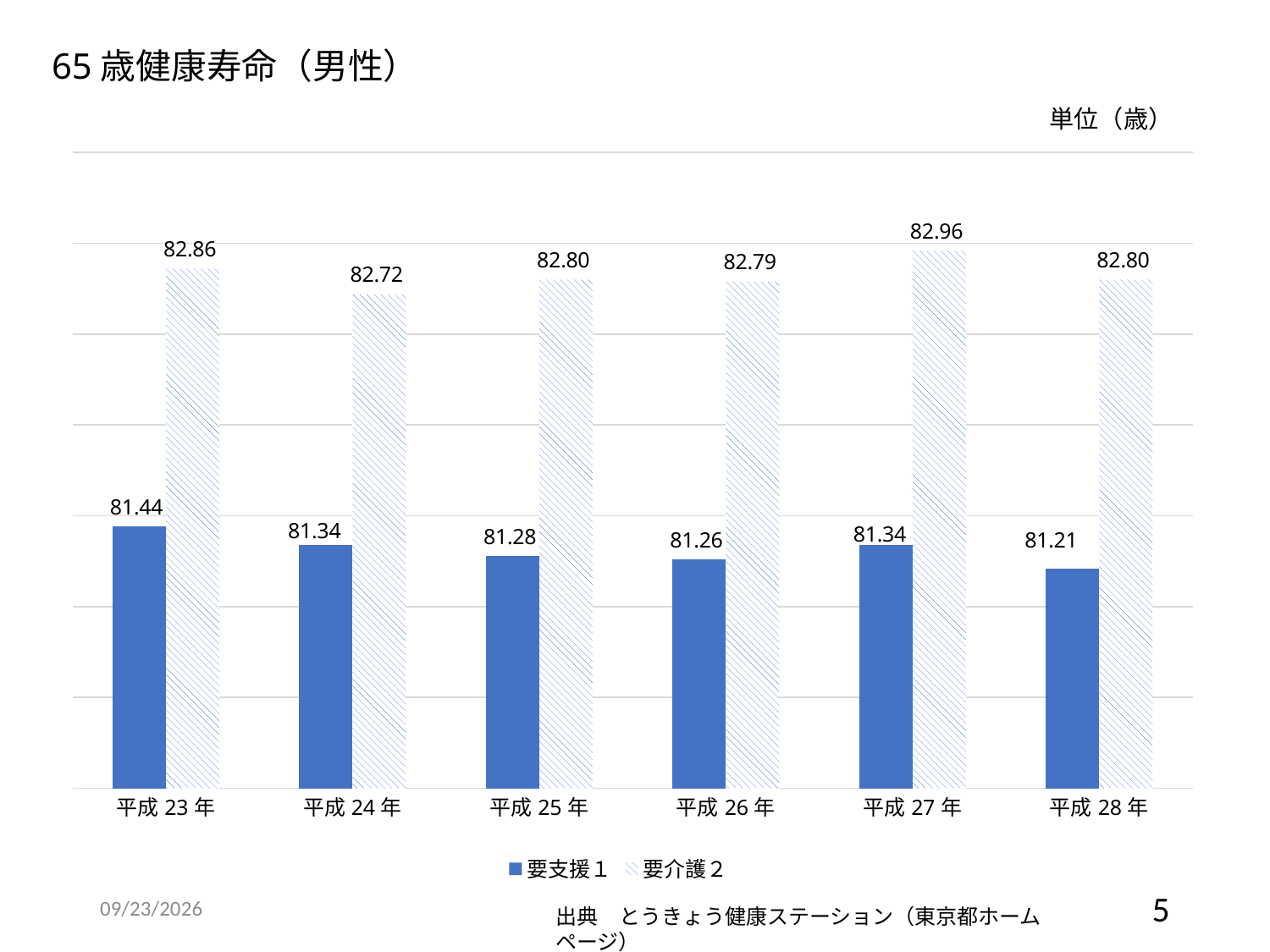
What is the value for 要支援１ in 平成 23 年? 81.44 What kind of chart is shown on the slide? Bar chart How many series does the legend list? 2 How many years are shown on the x axis? 6 What is the value for 要介護２ in 平成 24 年? 82.72 What is the title of the slide? 65 歳健康寿命（男性） Which year has the highest value for 要介護２? 平成 27 年 Which is larger: the 要支援１ value in 平成 23 年 or in 平成 28 年? 平成 23 年 What is the value for 要介護２ in 平成 27 年? 82.96 What is the value for 要支援１ in 平成 28 年? 81.21 What is the difference between the 要介護２ and 要支援１ values in 平成 23 年? 1.42 Which year has the lowest value for 要支援１? 平成 28 年